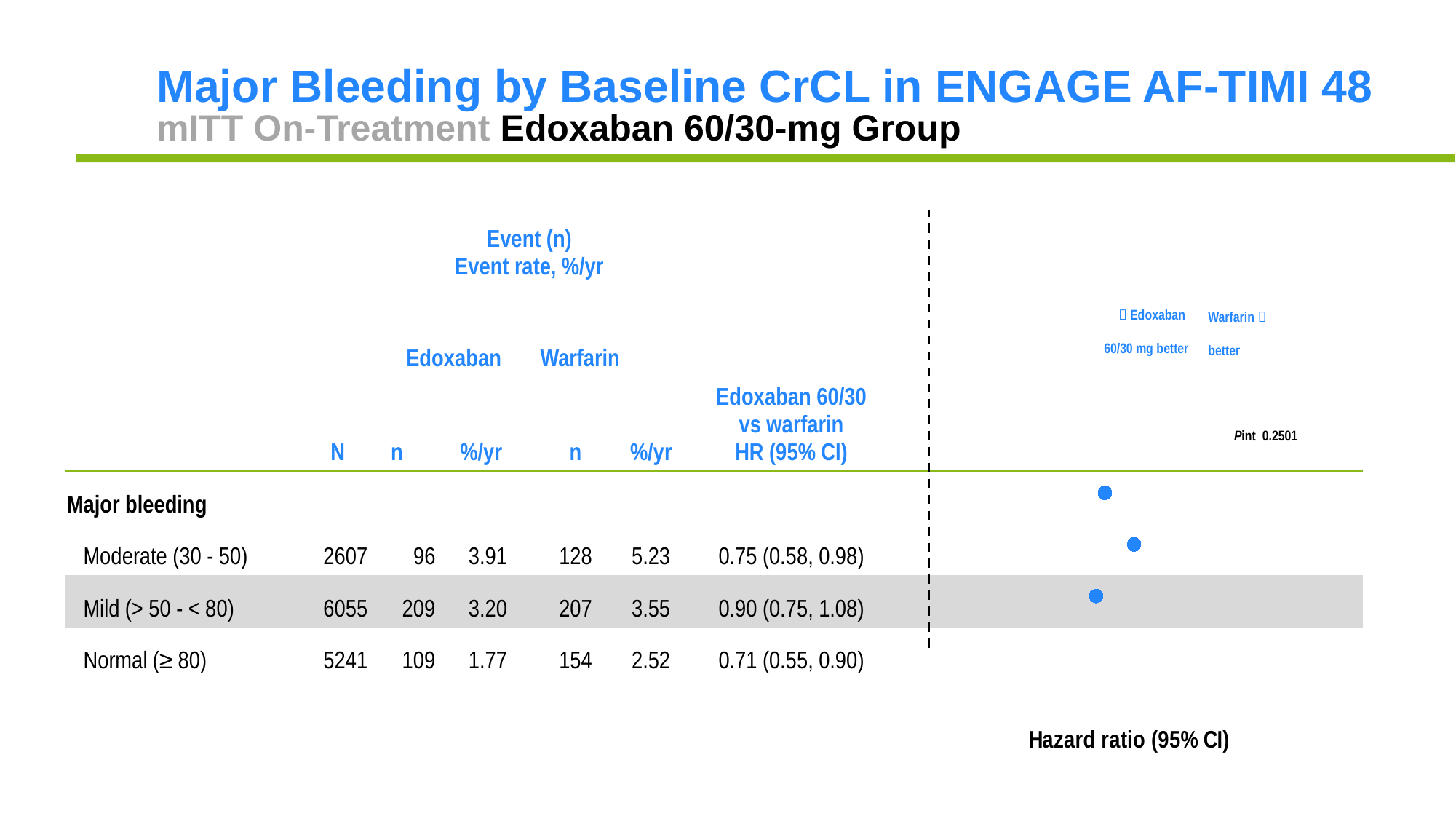
What is the hazard ratio plotted for the Normal (≥ 80) CrCL group? 0.71 What is the P value for interaction shown on the chart? 0.2501 Is the hazard ratio for the Mild (> 50 - < 80) group larger or smaller than that for the Normal (≥ 80) group? larger What is the label of the horizontal axis of the plot? Hazard ratio (95% CI) What is the 95% confidence interval for the hazard ratio in the Mild (> 50 - < 80) group? (0.75, 1.08) What is the difference between the hazard ratios of the Mild (> 50 - < 80) and Normal (≥ 80) groups? 0.19 Which CrCL group has the highest hazard ratio in the plot? Mild (> 50 - < 80) What kind of chart is shown on the right side of the slide? Forest plot Which CrCL group has the lowest hazard ratio in the plot? Normal (≥ 80) How many CrCL groups are plotted in the hazard ratio chart? 3 What is the hazard ratio plotted for the Moderate (30 - 50) CrCL group? 0.75 What is the hazard ratio plotted for the Mild (> 50 - < 80) CrCL group? 0.90